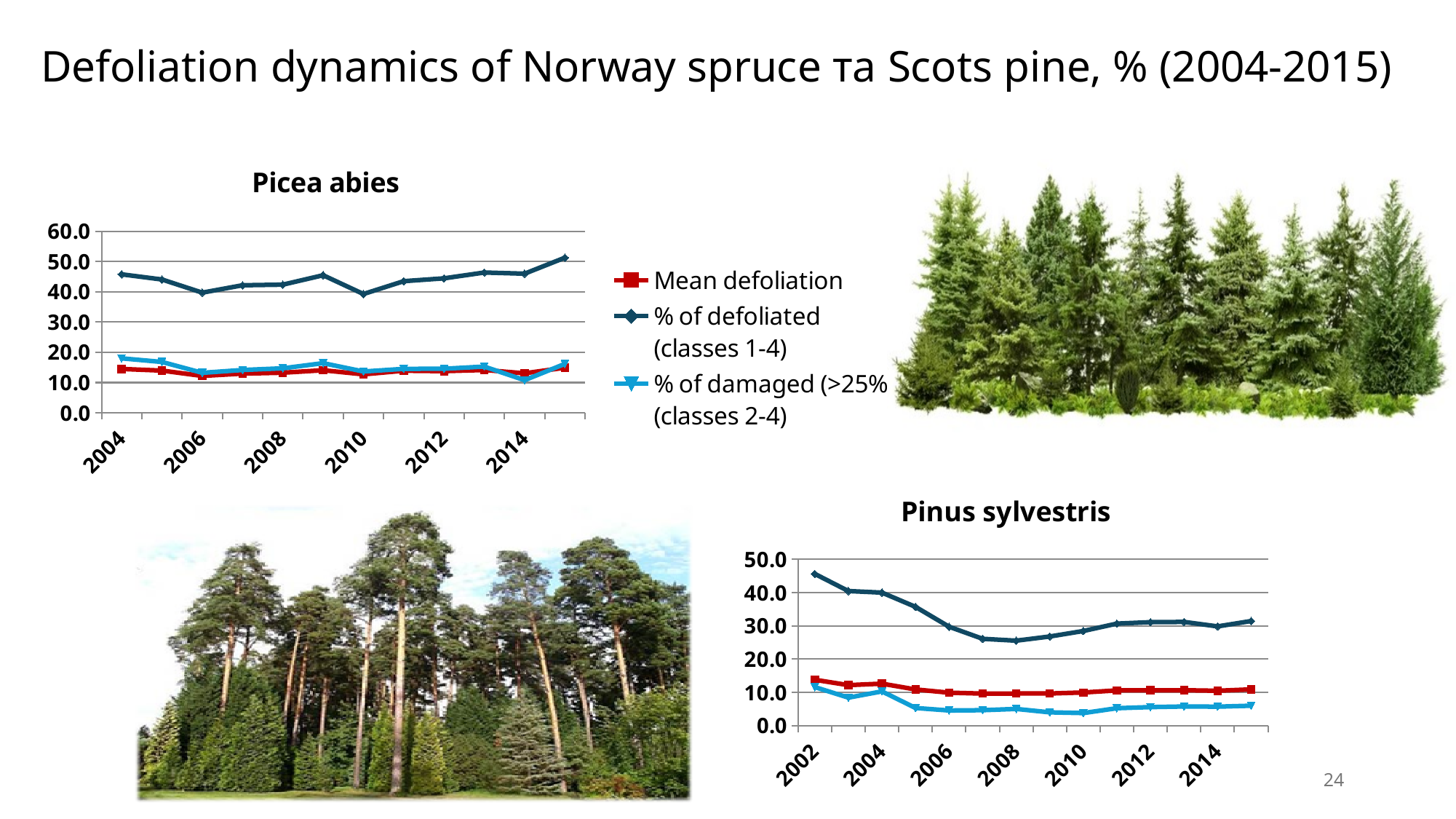
In the Pinus sylvestris chart, which year has the highest value for % of defoliated (classes 1-4)? 2002 How many series does the legend list for the charts? 3 In the Picea abies chart, which series is plotted in red? Mean defoliation In the Pinus sylvestris chart, is the value for % of defoliated (classes 1-4) in 2002 greater or less than 40.0? greater In the Pinus sylvestris chart, which series is higher in 2012: Mean defoliation or % of damaged (>25%) (classes 2-4)? Mean defoliation In the Picea abies chart, is the value for Mean defoliation in 2004 greater or less than 20.0? less In the Picea abies chart, which year has the highest value for % of defoliated (classes 1-4)? 2015 In the Pinus sylvestris chart, is the value for % of damaged (>25%) (classes 2-4) in 2010 greater or less than 10.0? less What kind of chart is the Picea abies chart? line chart In the Pinus sylvestris chart, does the % of defoliated (classes 1-4) series rise or fall from 2002 to 2008? fall What is the title of the chart in the lower right of the slide? Pinus sylvestris